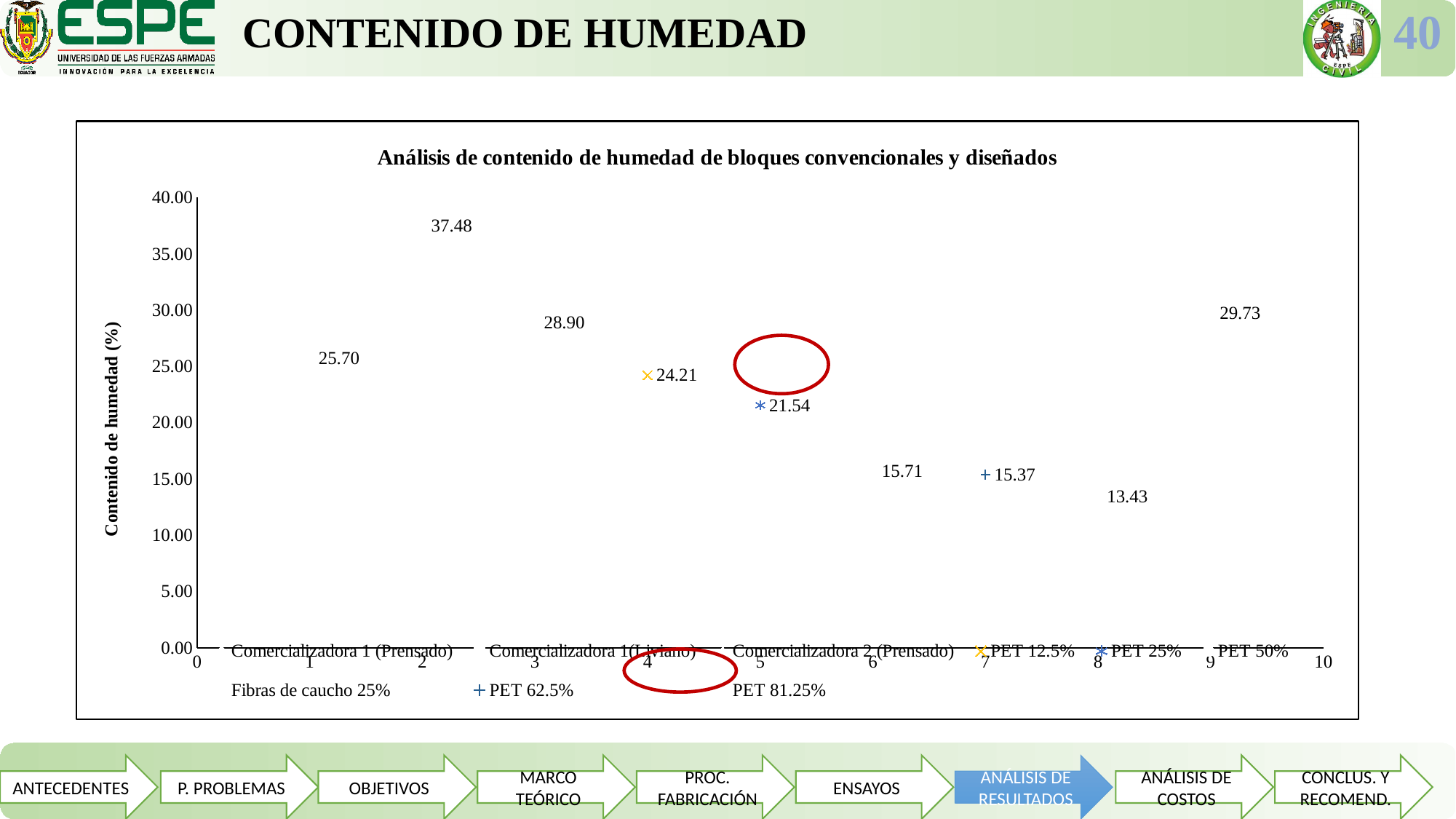
Is the value for PET 25% greater or less than 20.00? greater What is the moisture content value for PET 12.5%? 24.21 What is the difference between the values for PET 12.5% and PET 25%? 2.67 How many data points are plotted on the chart? 9 Which has a higher moisture content, PET 12.5% or PET 62.5%? PET 12.5% What is the highest moisture content value labelled on the chart? 37.48 What is the lowest moisture content value labelled on the chart? 13.43 What kind of chart is shown on the slide? Scatter chart What is the moisture content value for PET 25%? 21.54 What is the moisture content value for PET 62.5%? 15.37 How many series does the legend list? 9 What is the title of the chart? Análisis de contenido de humedad de bloques convencionales y diseñados